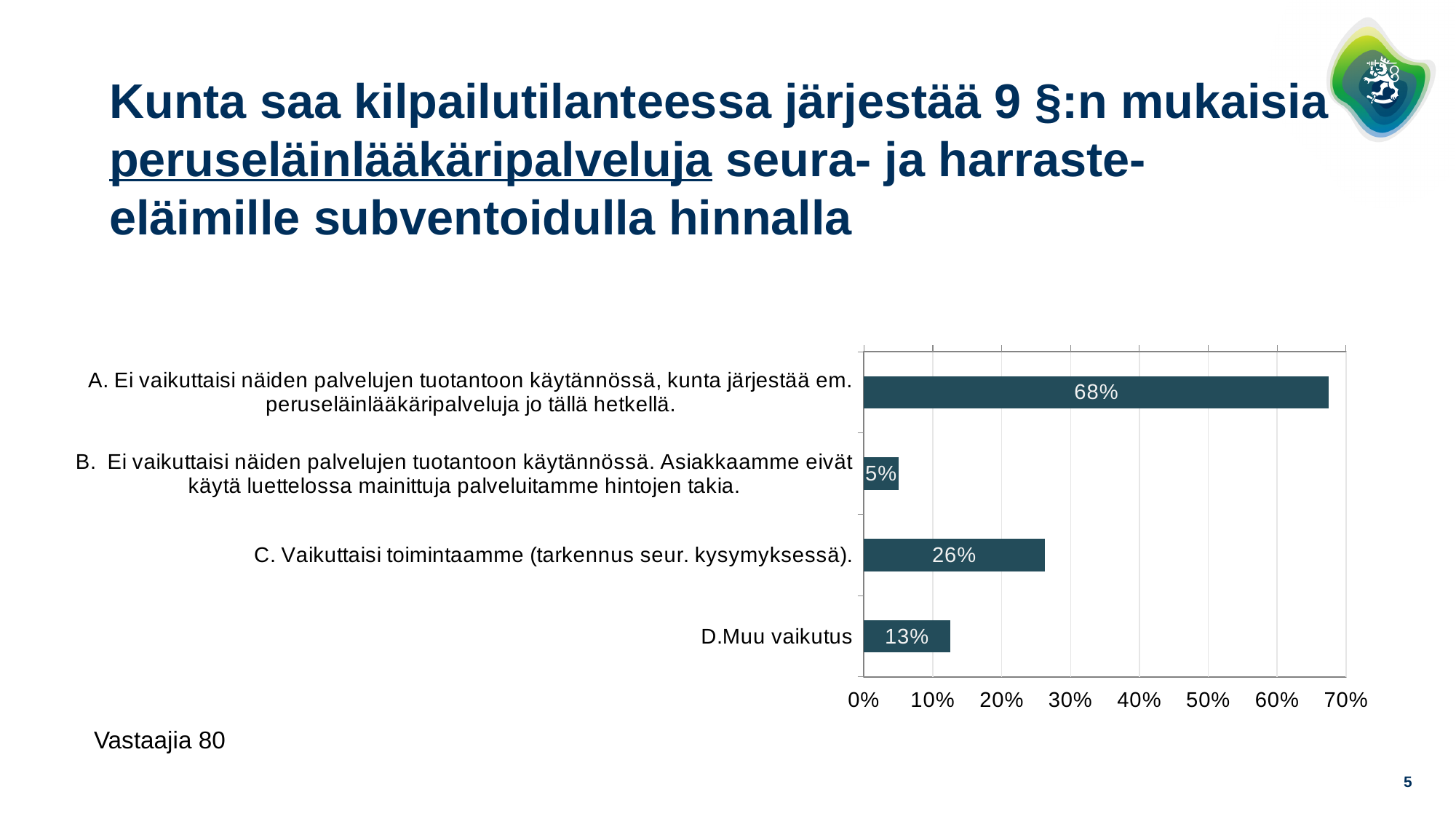
What is the difference between the values for option C and D. Muu vaikutus? 13% What kind of chart is shown on the slide? bar chart Which is larger, the value for option C or the value for D. Muu vaikutus? C. Vaikuttaisi toimintaamme (tarkennus seur. kysymyksessä). What is the difference between the values for option A and option C? 42% How many options (categories) are shown in the chart? 4 What is the value for option A (Ei vaikuttaisi näiden palvelujen tuotantoon käytännössä, kunta järjestää em. peruseläinlääkäripalveluja jo tällä hetkellä)? 68% Which option has the highest value? A. Ei vaikuttaisi näiden palvelujen tuotantoon käytännössä, kunta järjestää em. peruseläinlääkäripalveluja jo tällä hetkellä. Which option has the lowest value? B. Ei vaikuttaisi näiden palvelujen tuotantoon käytännössä. Asiakkaamme eivät käytä luettelossa mainittuja palveluitamme hintojen takia. What is the value for option B (Asiakkaamme eivät käytä luettelossa mainittuja palveluitamme hintojen takia)? 5% Is the value for option A greater or less than 60%? greater What is the value for option C (Vaikuttaisi toimintaamme)? 26% What is the value for D. Muu vaikutus? 13%